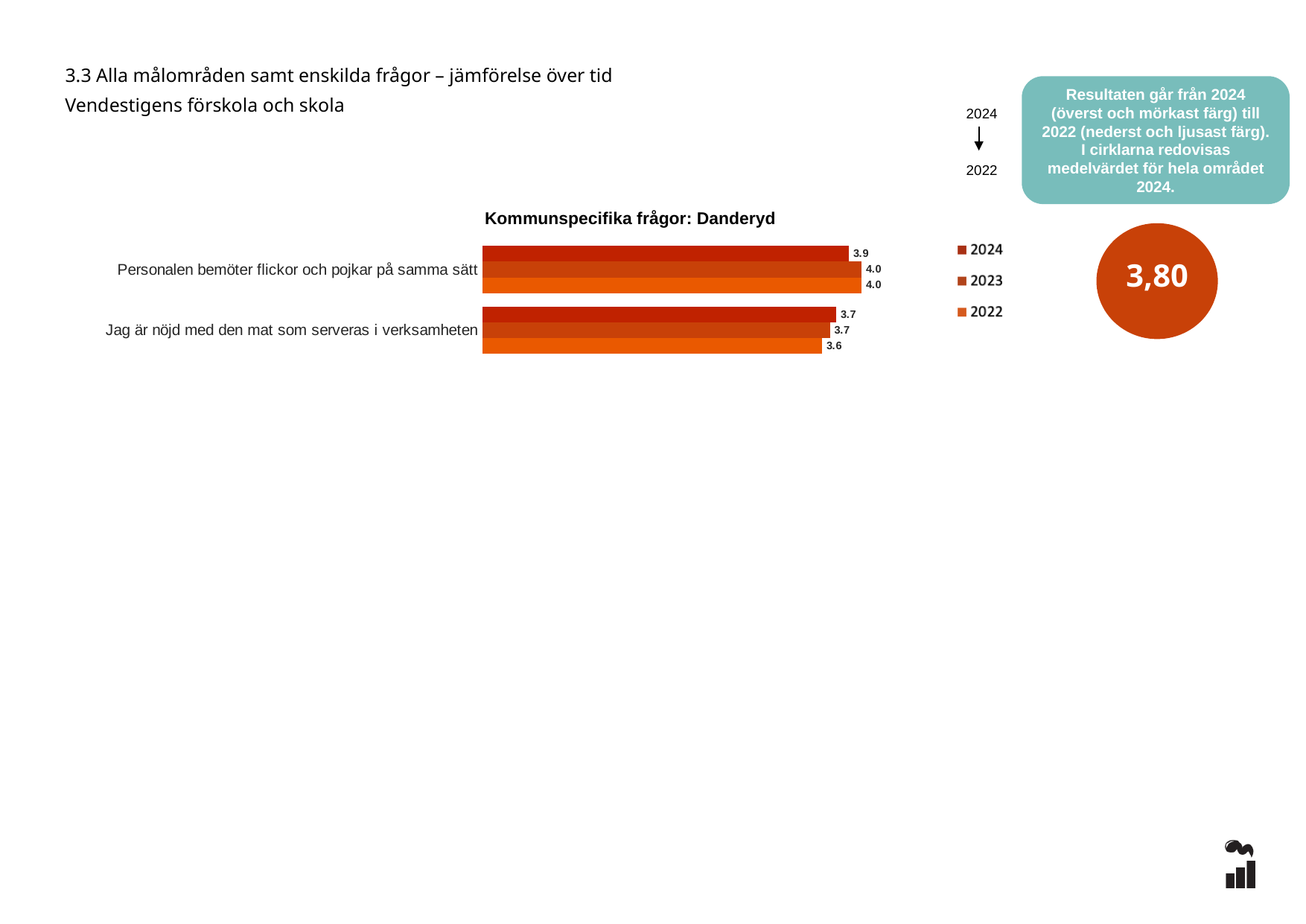
What is the title of the chart? Kommunspecifika frågor: Danderyd What kind of chart is shown on the slide? Bar chart What is the 2024 value for "Jag är nöjd med den mat som serveras i verksamheten"? 3.7 Which category has the lowest 2022 value? Jag är nöjd med den mat som serveras i verksamheten How many series does the legend list? 3 What is the 2024 value for "Personalen bemöter flickor och pojkar på samma sätt"? 3.9 What is the 2023 value for "Personalen bemöter flickor och pojkar på samma sätt"? 4.0 Which category has the highest 2024 value? Personalen bemöter flickor och pojkar på samma sätt Which is larger for "Personalen bemöter flickor och pojkar på samma sätt": the 2024 value or the 2022 value? 2022 How many categories are shown in the chart? 2 What is the 2022 value for "Jag är nöjd med den mat som serveras i verksamheten"? 3.6 What is the difference between the 2022 values of "Personalen bemöter flickor och pojkar på samma sätt" and "Jag är nöjd med den mat som serveras i verksamheten"? 0.4